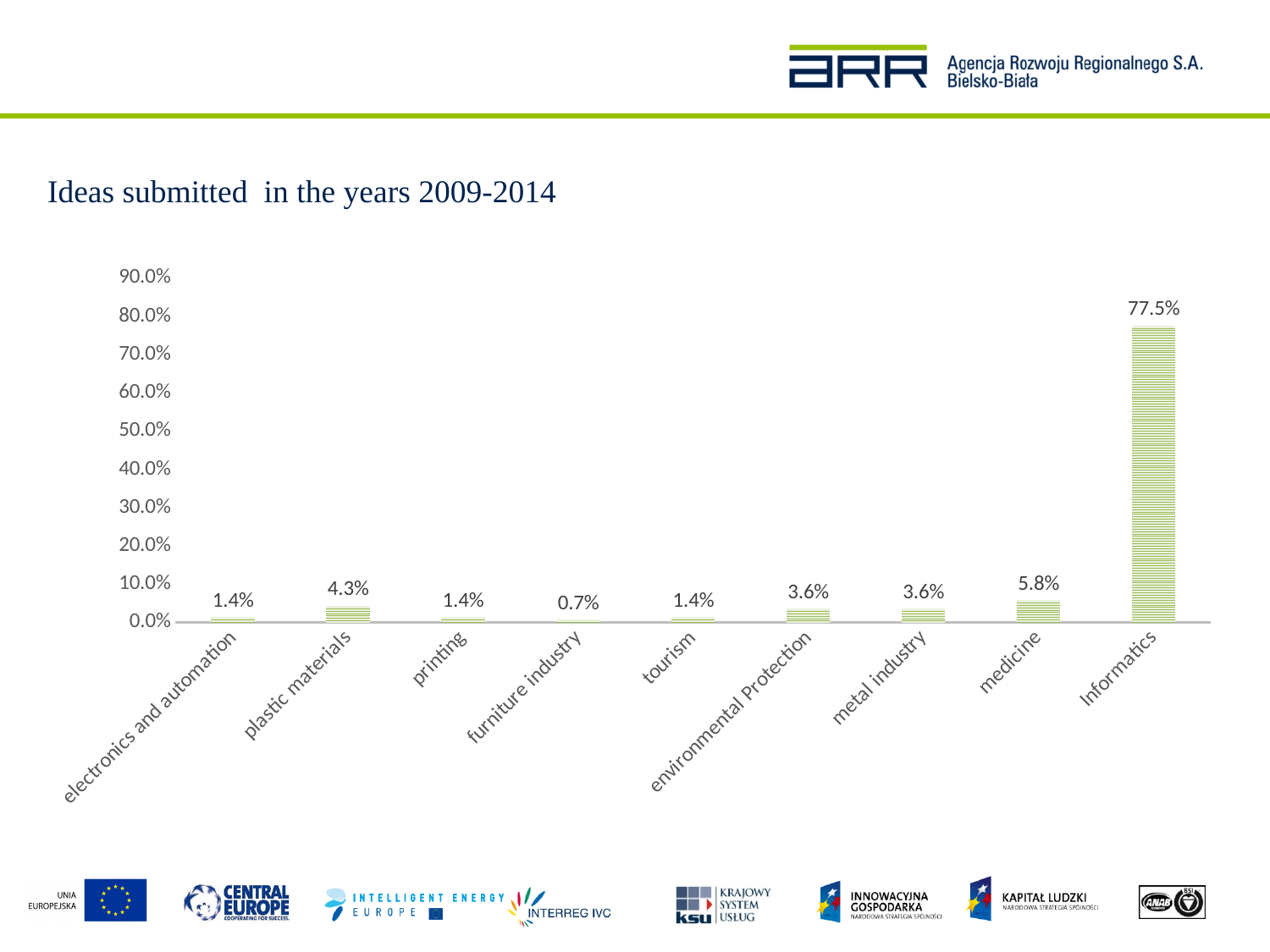
Which is larger, the value for medicine or the value for metal industry? medicine Which category has the highest value? Informatics What is the value for Informatics? 77.5% What is the value for furniture industry? 0.7% How many categories are shown on the x axis? 9 What is the difference between the values for plastic materials and environmental Protection? 0.7% Which category has the lowest value? furniture industry What is the value for plastic materials? 4.3% What is the value for medicine? 5.8% What kind of chart is shown on the slide? bar chart What is the difference between the values for Informatics and medicine? 71.7% Is the value for Informatics greater or less than 70.0%? greater